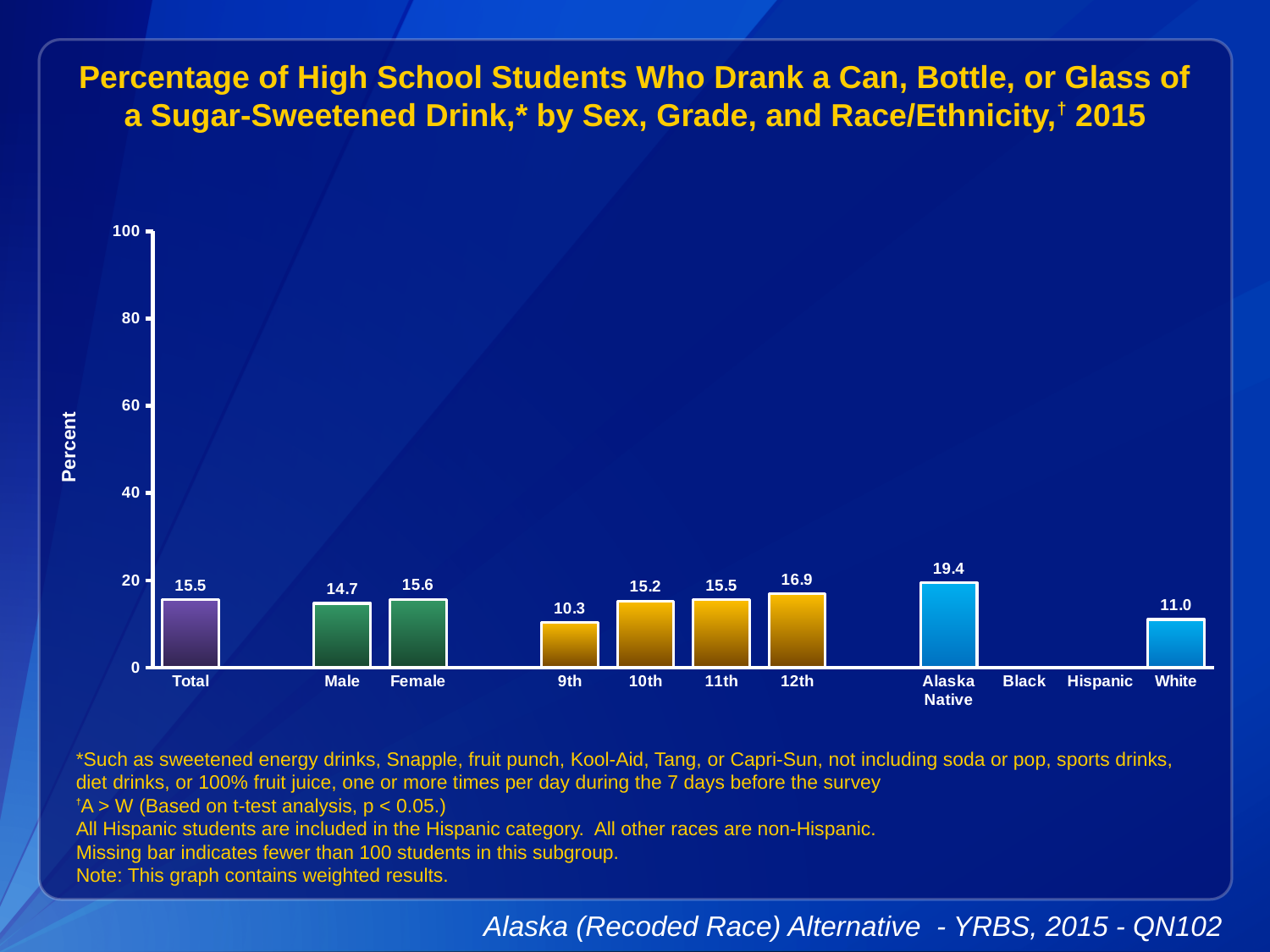
Do the values rise or fall from 9th grade to 12th grade? rise How many bars are plotted on the chart? 9 Which category has the highest bar? Alaska Native What is the value for 9th grade students? 10.3 Is the value for White students greater or less than 20? less Which is larger, the value for Male or the value for Female? Female What is the difference between the 12th grade value and the 9th grade value? 6.6 What is the value for Total? 15.5 Which two race/ethnicity categories have no bar shown? Black and Hispanic What percentage is shown for Alaska Native students? 19.4 Which plotted category has the lowest value? 9th What kind of chart is shown on the slide? bar chart